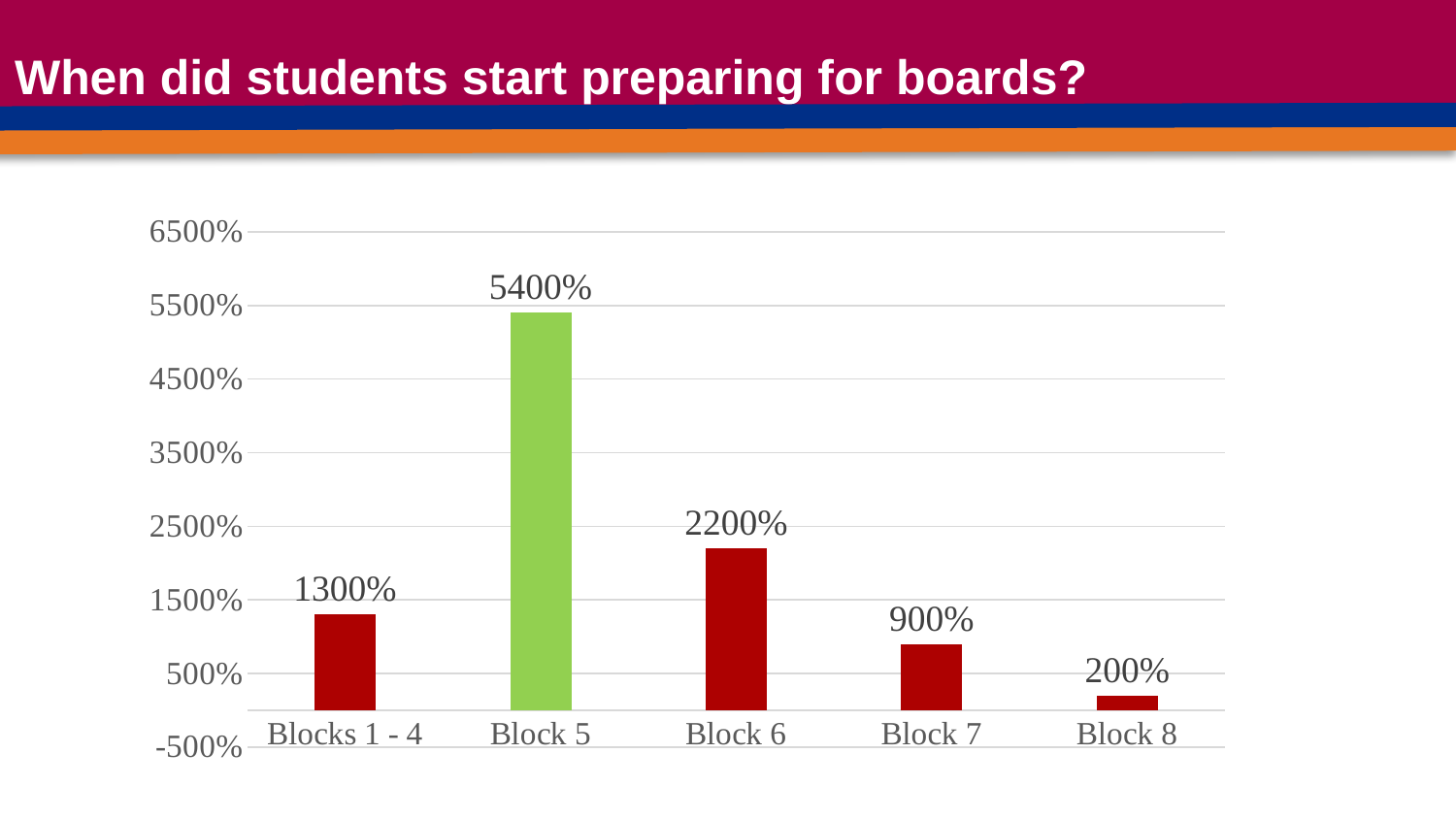
Which is larger, the value for Blocks 1 - 4 or the value for Block 6? Block 6 What is the difference between the values for Block 5 and Block 6? 3200% How many categories are shown on the x axis? 5 What is the value for Block 8? 200% What is the value for Block 5? 5400% What is the difference between the values for Block 7 and Block 8? 700% Which category has the highest value? Block 5 Is the value for Block 7 greater or less than 1500%? less Which category has the lowest value? Block 8 What is the value for Blocks 1 - 4? 1300% What is the title of the slide? When did students start preparing for boards? What kind of chart is shown on the slide? bar chart